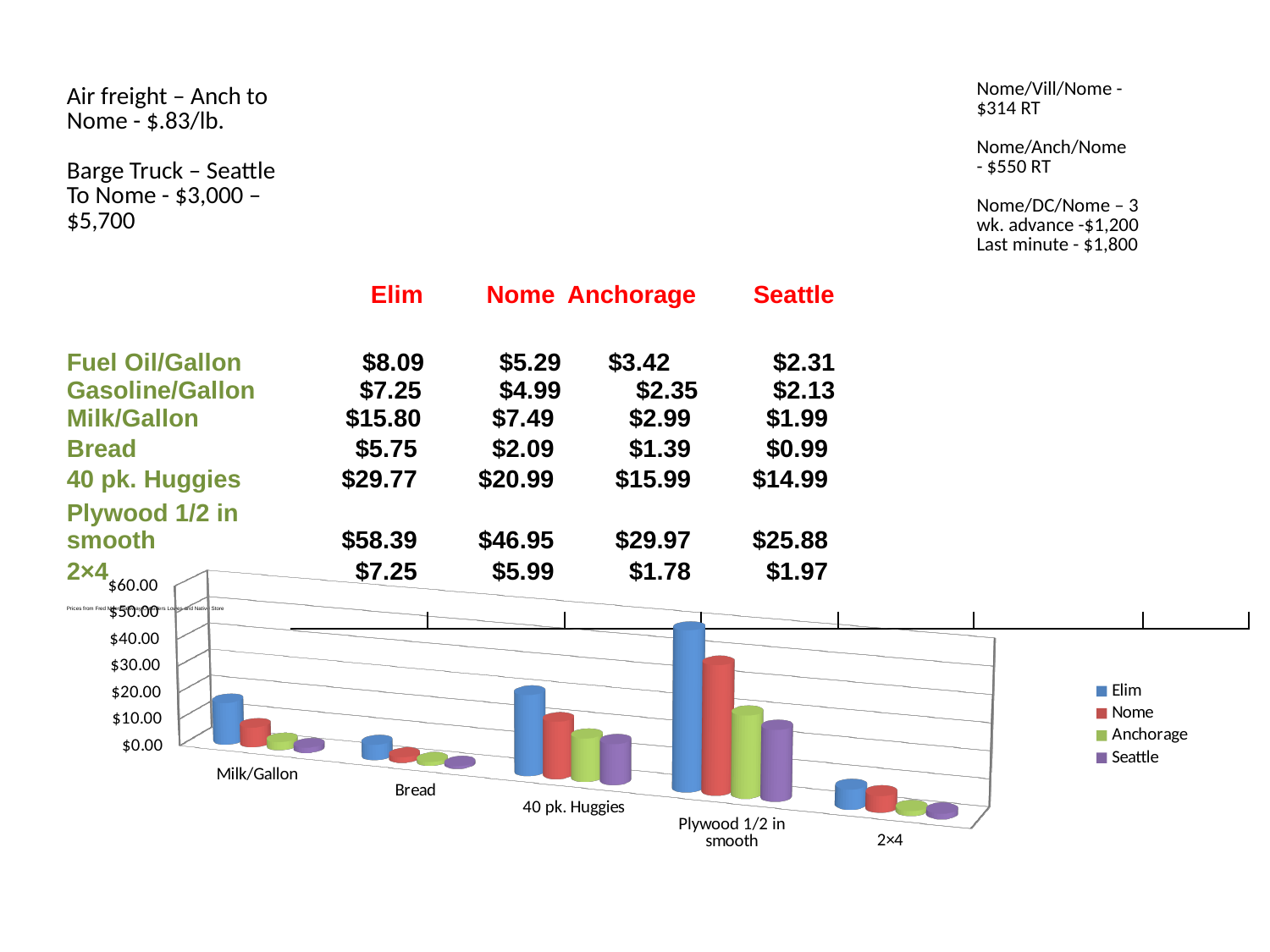
What is the Seattle value for 40 pk. Huggies, as printed on the slide? $14.99 How many categories are shown along the x axis of the chart? 5 Is the Elim value for Milk/Gallon greater or less than $10.00? greater Which is larger, the Elim bar for Plywood 1/2 in smooth or the Elim bar for 40 pk. Huggies? Plywood 1/2 in smooth Is the Nome value for Bread greater or less than $10.00? less Is the Elim value for Plywood 1/2 in smooth greater or less than $50.00? greater Which series is shown in green in the chart legend? Anchorage How many series does the chart legend list? 4 What kind of chart is shown on the slide? bar chart Which series has the tallest bar for Plywood 1/2 in smooth? Elim Which category has the tallest bar in the chart? Plywood 1/2 in smooth What is the Elim value for Plywood 1/2 in smooth, as printed on the slide? $58.39